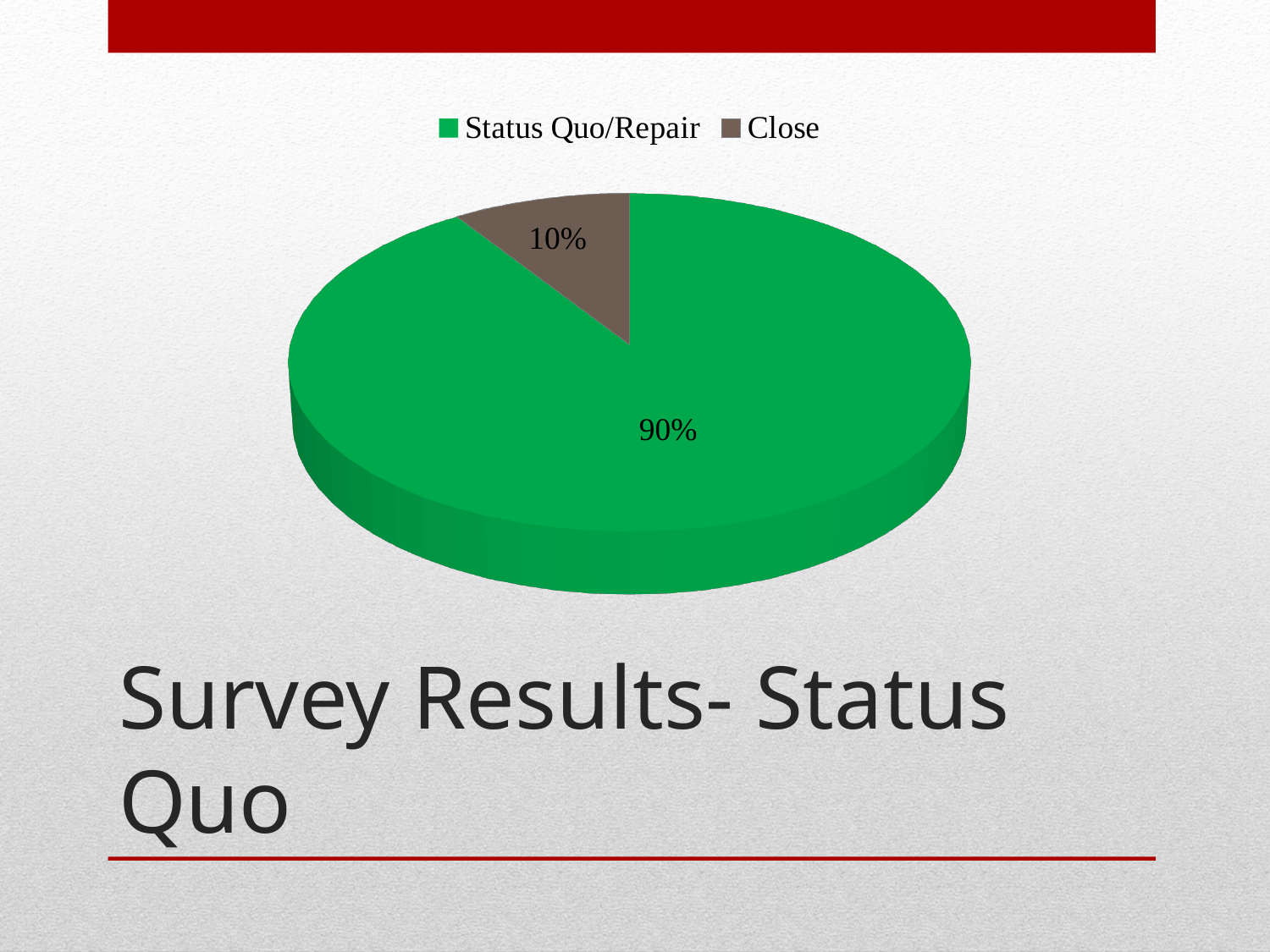
What percentage of the pie is labelled for Status Quo/Repair? 90% What percentage of the pie is labelled for Close? 10% Which category has the largest share of the pie? Status Quo/Repair What is the title text shown on the slide below the chart? Survey Results- Status Quo How many entries does the legend list? 2 What kind of chart is shown on the slide? Pie chart How many slices does the pie chart have? 2 Which is larger, the Close slice or the Status Quo/Repair slice? Status Quo/Repair What colour is the Status Quo/Repair slice? Green Which category has the smallest share of the pie? Close What share of the pie does the Close slice represent? 10% What is the difference in percentage points between the Status Quo/Repair slice and the Close slice? 80